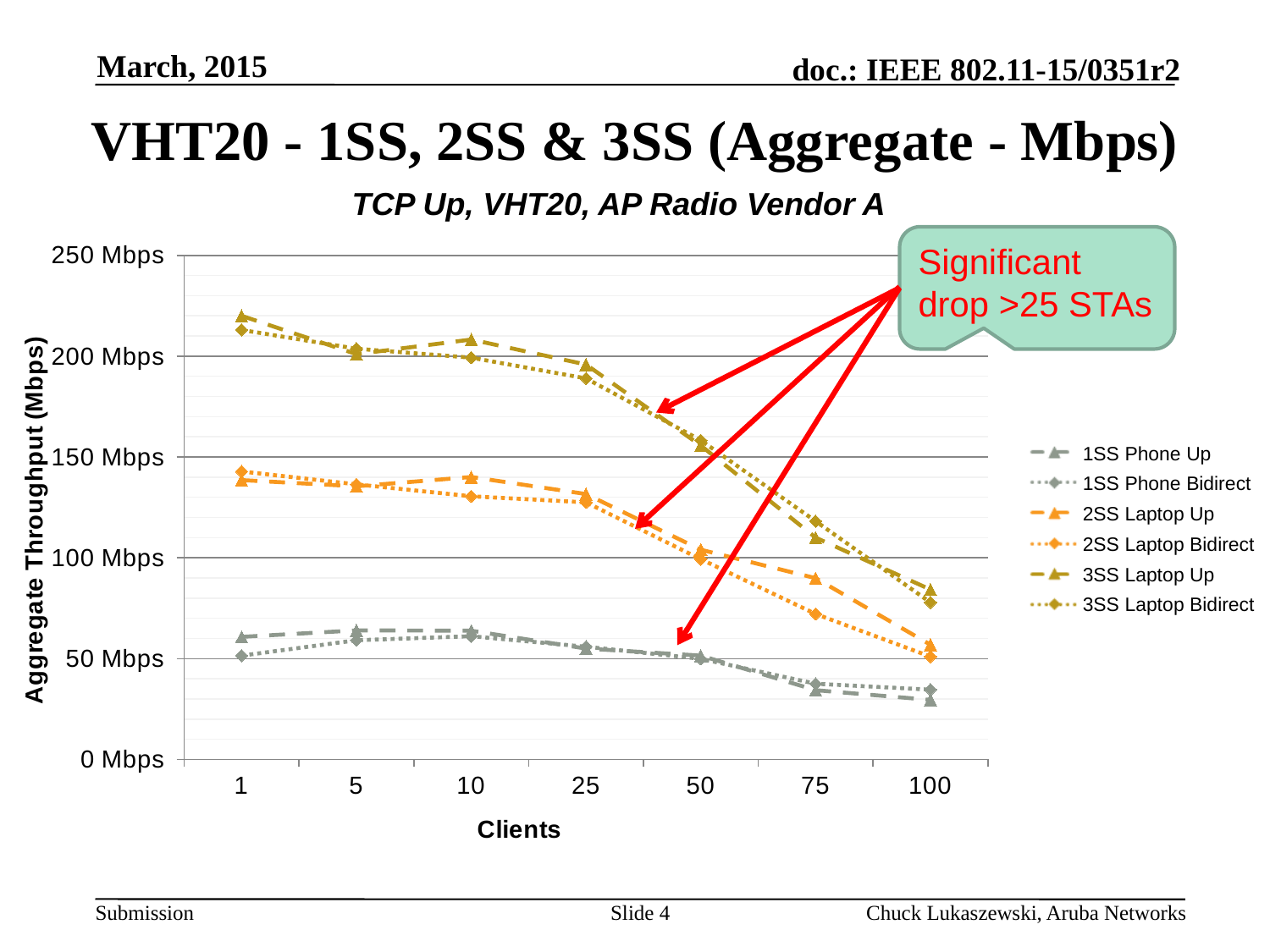
Is the value for 1SS Phone Up at 100 clients greater or less than 50 Mbps? less At 50 clients, which series has the higher value, 2SS Laptop Up or 1SS Phone Up? 2SS Laptop Up Does the 1SS Phone Up series rise or fall from 50 clients to 100 clients? fall What is the label of the y axis? Aggregate Throughput (Mbps) What kind of chart is shown on the slide? line chart What is the title of the chart? TCP Up, VHT20, AP Radio Vendor A Does the 3SS Laptop Up series rise or fall as the number of clients increases from 25 to 100? fall How many client counts are plotted along the x axis? 7 How many series does the legend list? 6 Is the value for 2SS Laptop Up at 1 client greater or less than 150 Mbps? less Is the value for 3SS Laptop Up at 75 clients greater or less than 100 Mbps? greater